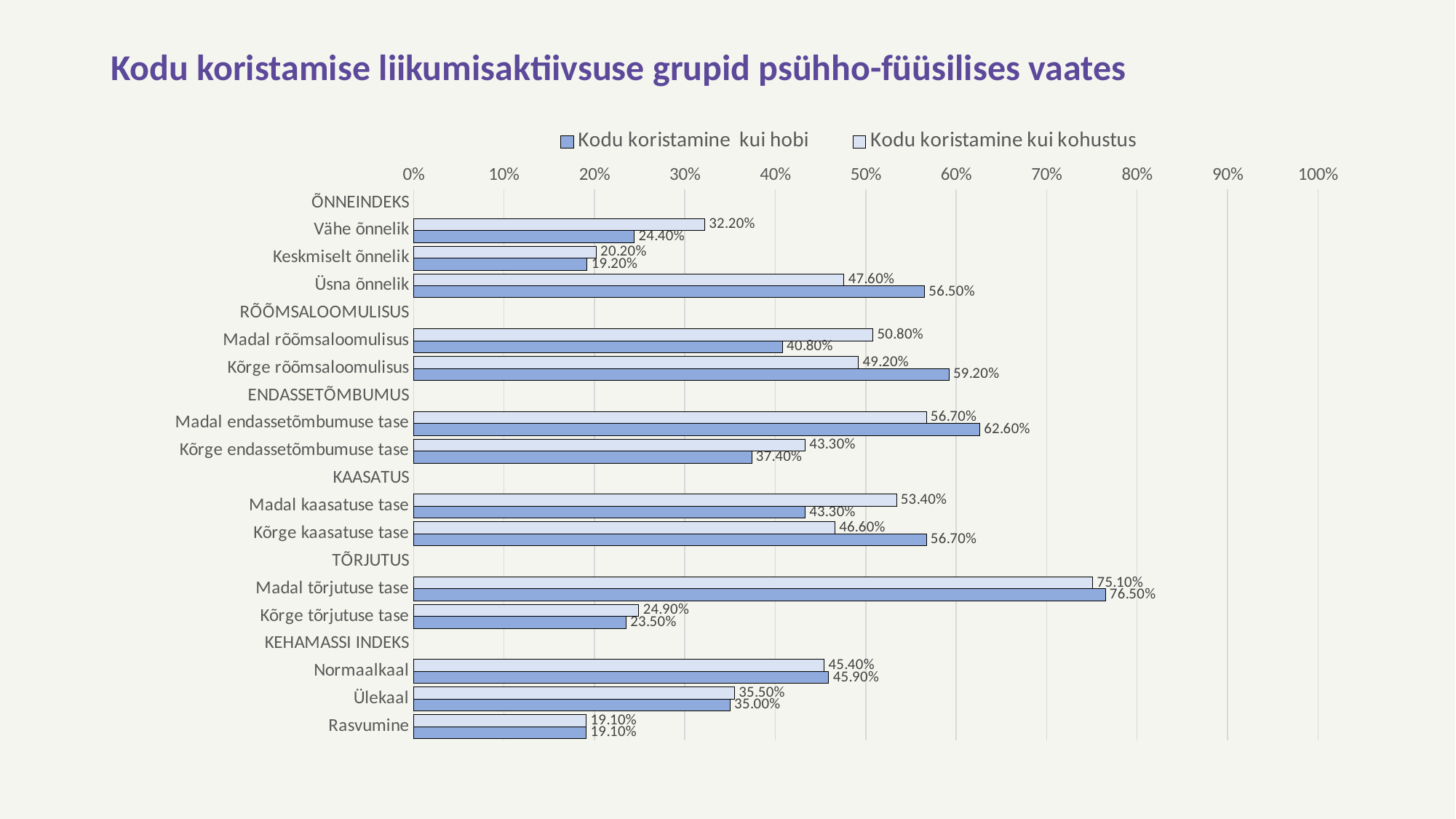
What is the value for "Rasvumine" in the "Kodu koristamine kui hobi" series? 19.10% For "Madal endassetõmbumuse tase", which series has the larger value: "Kodu koristamine kui hobi" or "Kodu koristamine kui kohustus"? Kodu koristamine kui hobi Is the "Kodu koristamine kui kohustus" value for "Madal tõrjutuse tase" greater or less than 70%? greater What is the title of the chart? Kodu koristamise liikumisaktiivsuse grupid psühho-füüsilises vaates Which category has the lowest value in the "Kodu koristamine kui kohustus" series? Rasvumine What is the difference between the "Kodu koristamine kui kohustus" values for "Vähe õnnelik" and "Keskmiselt õnnelik"? 12.00% How many series does the legend list? 2 Which category has the highest value in the "Kodu koristamine kui hobi" series? Madal tõrjutuse tase What is the value for "Madal kaasatuse tase" in the "Kodu koristamine kui kohustus" series? 53.40% What is the difference between the "Kodu koristamine kui hobi" and "Kodu koristamine kui kohustus" values for "Kõrge rõõmsaloomulisus"? 10.00% What kind of chart is shown on the slide? Bar chart What is the value for "Üsna õnnelik" in the "Kodu koristamine kui hobi" series? 56.50%